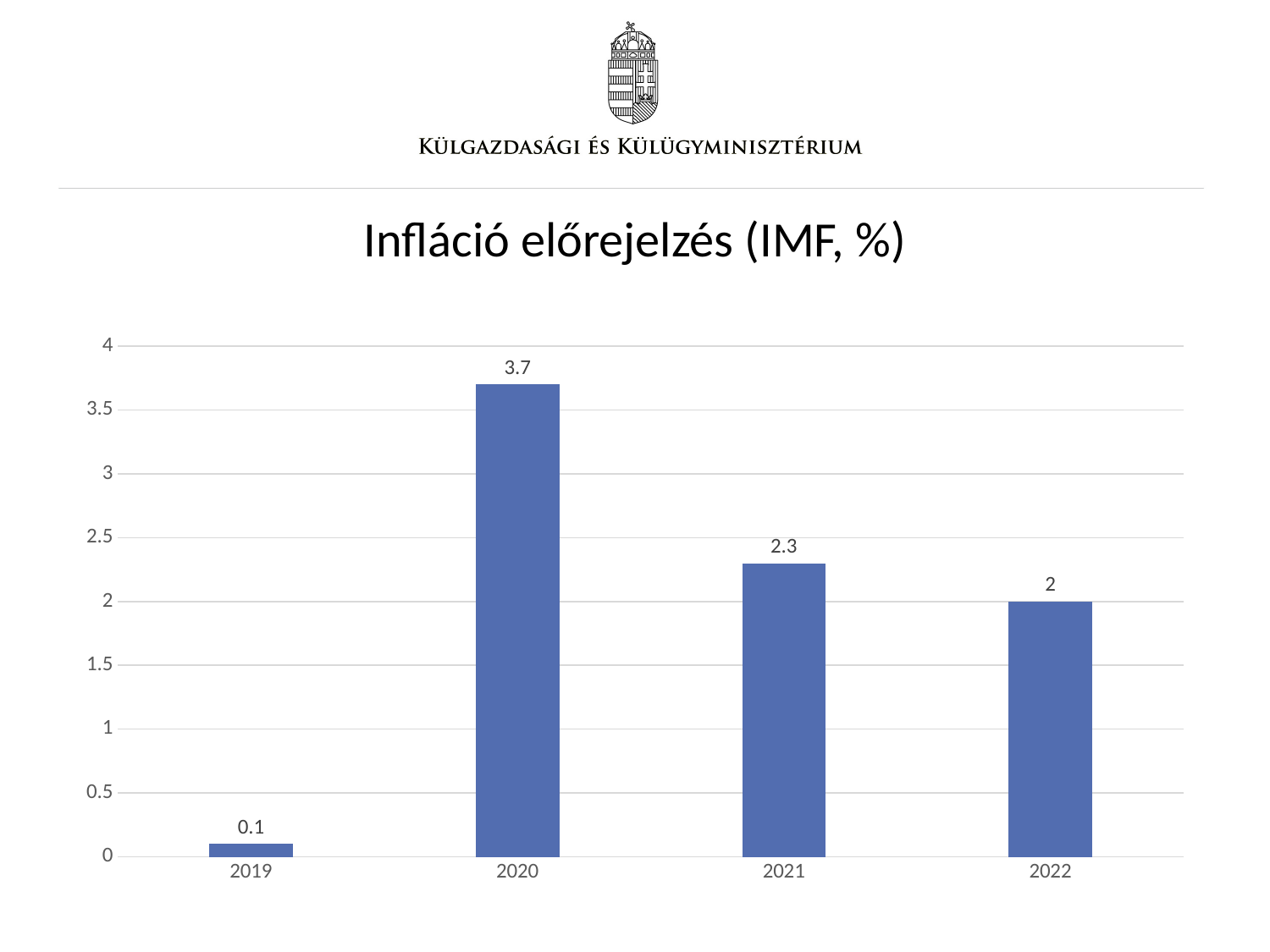
What is the inflation forecast value for 2020? 3.7 What is the inflation forecast value for 2019? 0.1 Is the value for 2020 greater or less than 3.5? greater Which year has the highest inflation forecast? 2020 Which is larger, the value for 2021 or the value for 2022? 2021 Do the values rise or fall from 2020 to 2022? fall What is the difference between the 2020 and 2021 values? 1.4 Which year has the lowest inflation forecast? 2019 How many years are shown on the x axis? 4 What is the title of the chart? Infláció előrejelzés (IMF, %) What kind of chart is shown on the slide? bar chart What is the inflation forecast value for 2022? 2